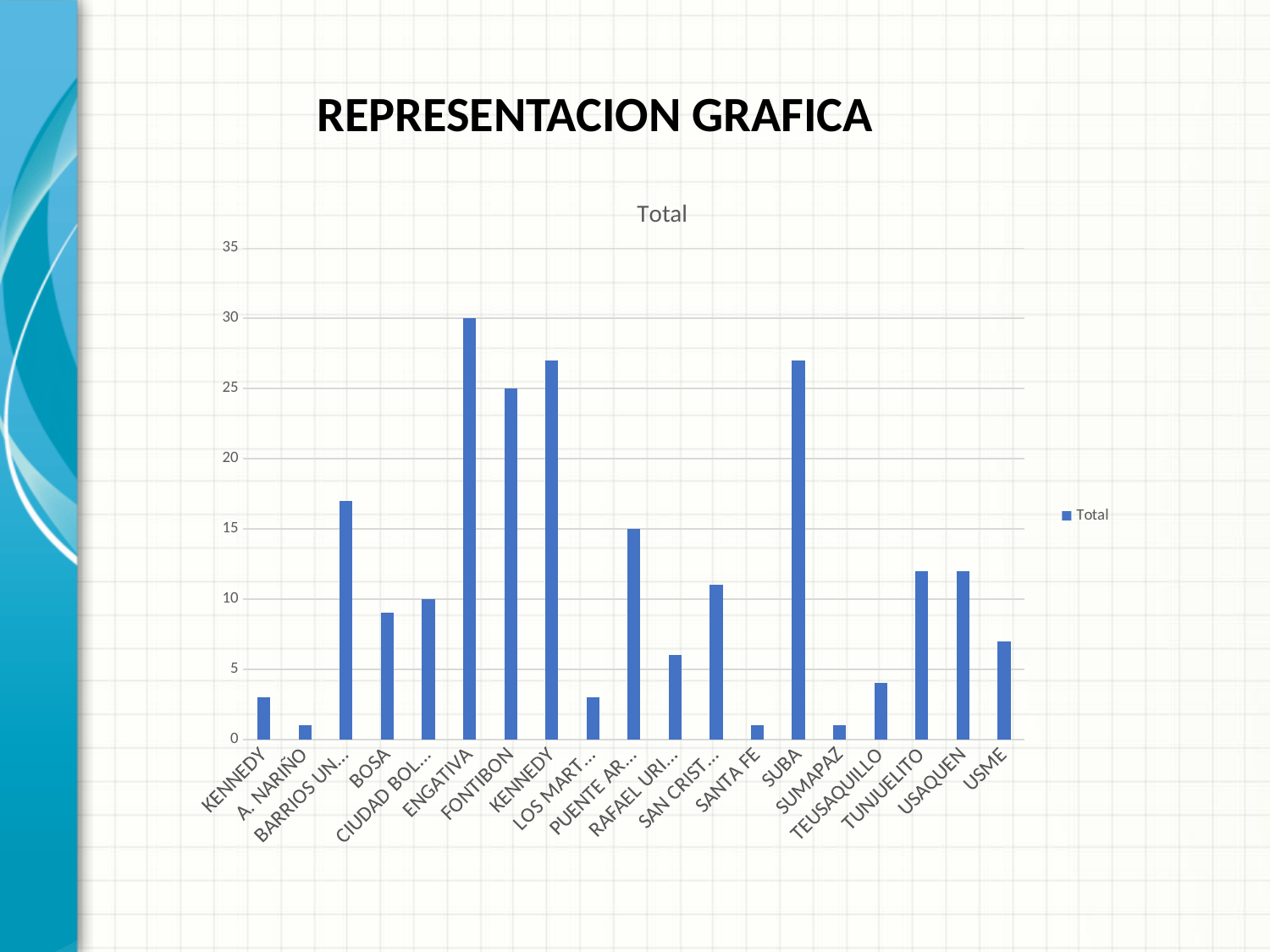
What is the title of the chart? Total What is the value for ENGATIVA? 30 What is the value for FONTIBON? 25 Which is larger, the value for SUBA or the value for BOSA? SUBA How many series does the legend list? 1 What type of chart is shown on the slide? bar chart Is the value for TEUSAQUILLO greater or less than 5? less What is the difference between the values for ENGATIVA and FONTIBON? 5 Which category has the highest value? ENGATIVA Is the value for BARRIOS UN... greater or less than 15? greater Is the value for SUBA greater or less than 25? greater How many categories are shown on the x axis? 19